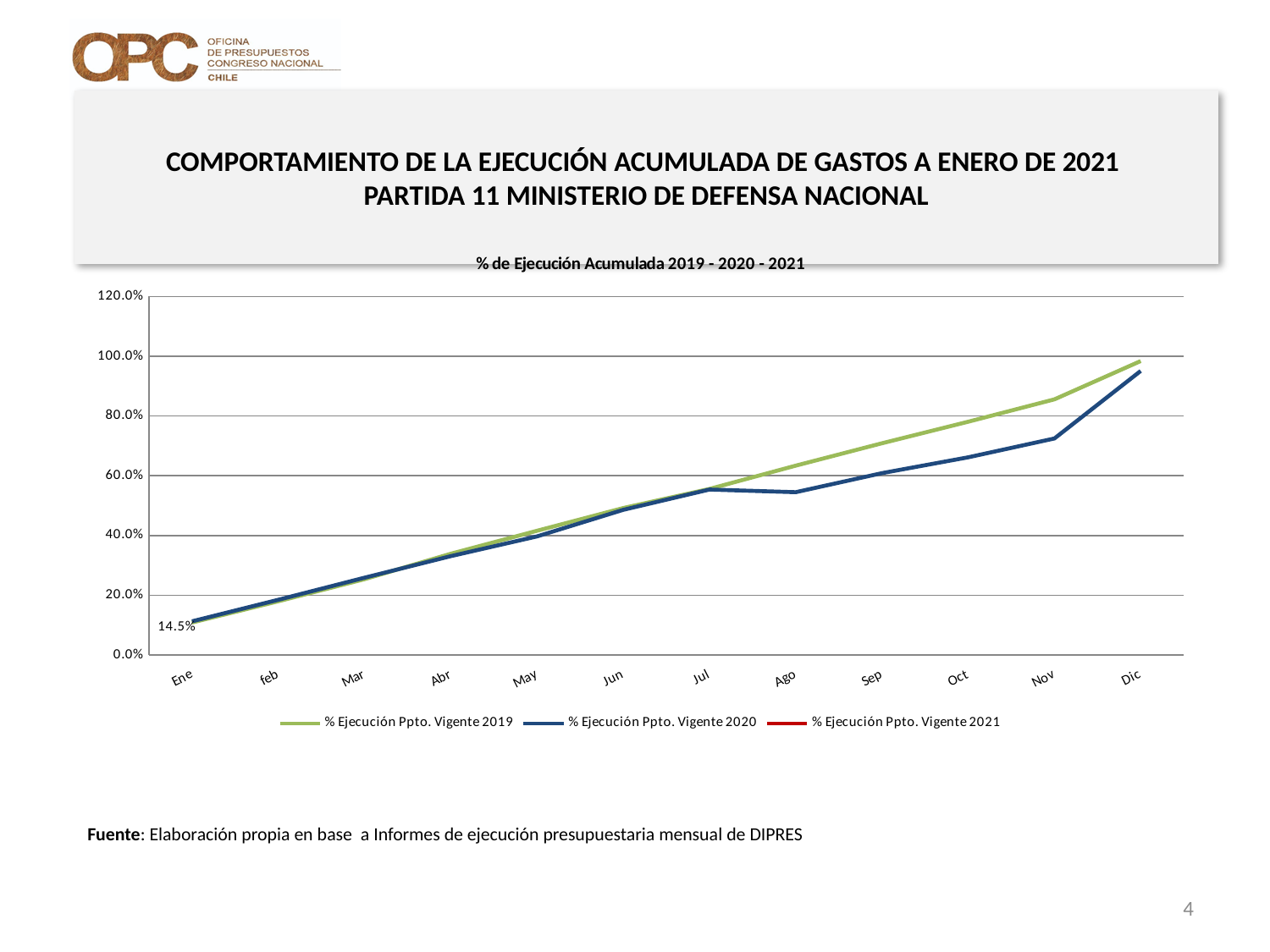
Does the % Ejecución Ppto. Vigente 2019 line rise or fall from Ene to Dic? Rise In which month is % Ejecución Ppto. Vigente 2020 at its lowest value? Ene At Nov, which series is higher: % Ejecución Ppto. Vigente 2019 or % Ejecución Ppto. Vigente 2020? % Ejecución Ppto. Vigente 2019 How many months are shown along the x axis? 12 Is the value for % Ejecución Ppto. Vigente 2019 at Dic greater or less than 80.0%? greater What type of chart is shown on the slide? Line chart What value is printed as a data label at Ene? 14.5% In which month does % Ejecución Ppto. Vigente 2019 reach its highest value? Dic How many series does the legend list? 3 What is the title of the chart? % de Ejecución Acumulada 2019 - 2020 - 2021 Is the value for % Ejecución Ppto. Vigente 2020 at Dic greater or less than 80.0%? greater Is the value for % Ejecución Ppto. Vigente 2020 at Ago greater or less than 60.0%? less